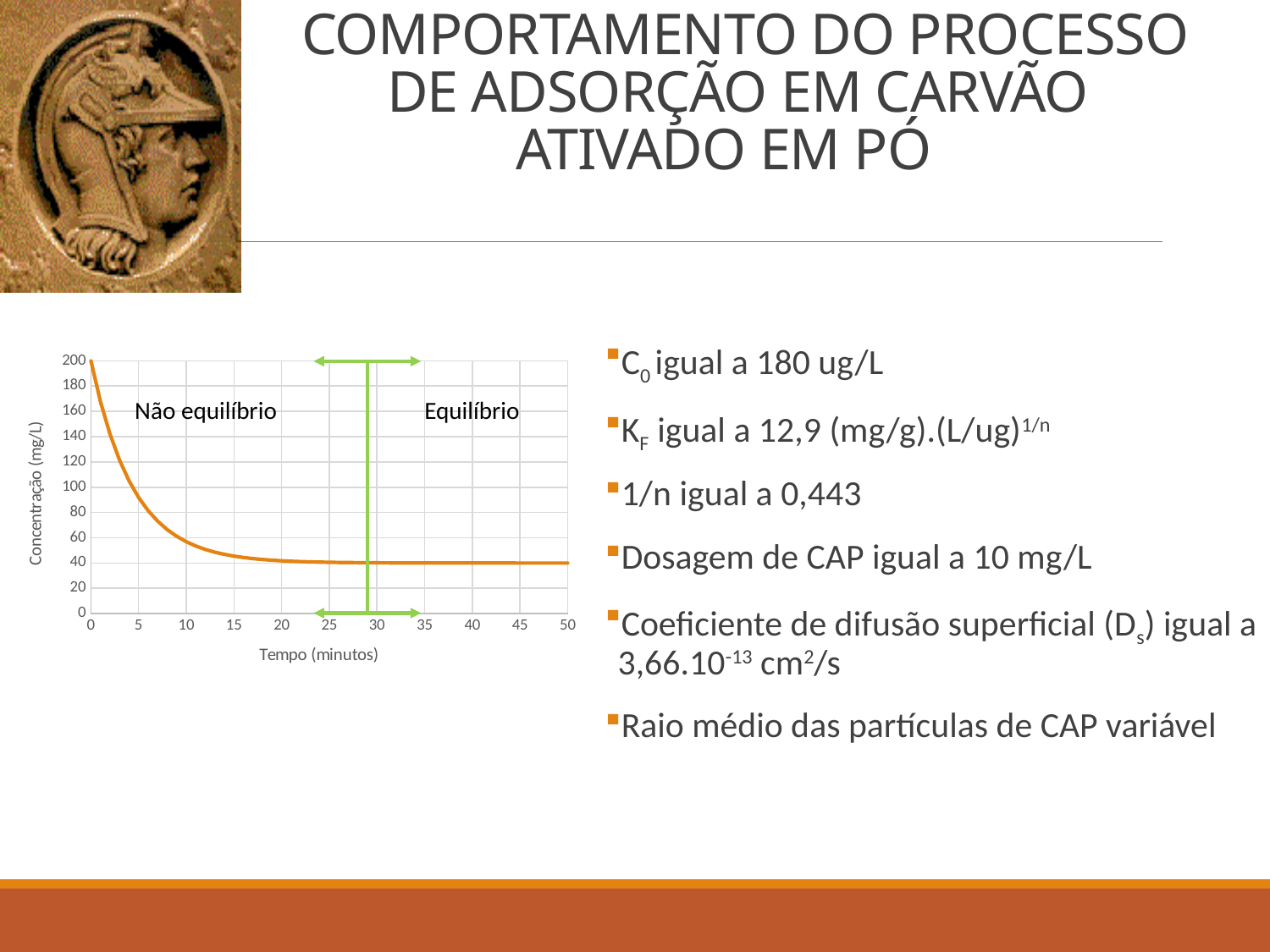
What is the label of the x axis of the chart? Tempo (minutos) Is the concentration at 20 minutes greater or less than 60? less Is the concentration at 40 minutes greater or less than 20? greater At which time (in minutes) is the concentration highest? 0 Is the concentration at 10 minutes greater or less than 100? less What kind of chart is shown on the slide? line chart Does the concentration rise or fall as time increases along the x axis? fall What label is written in the region of the chart to the right of the vertical green line? Equilíbrio Which is larger, the concentration at 5 minutes or at 30 minutes? 5 minutes